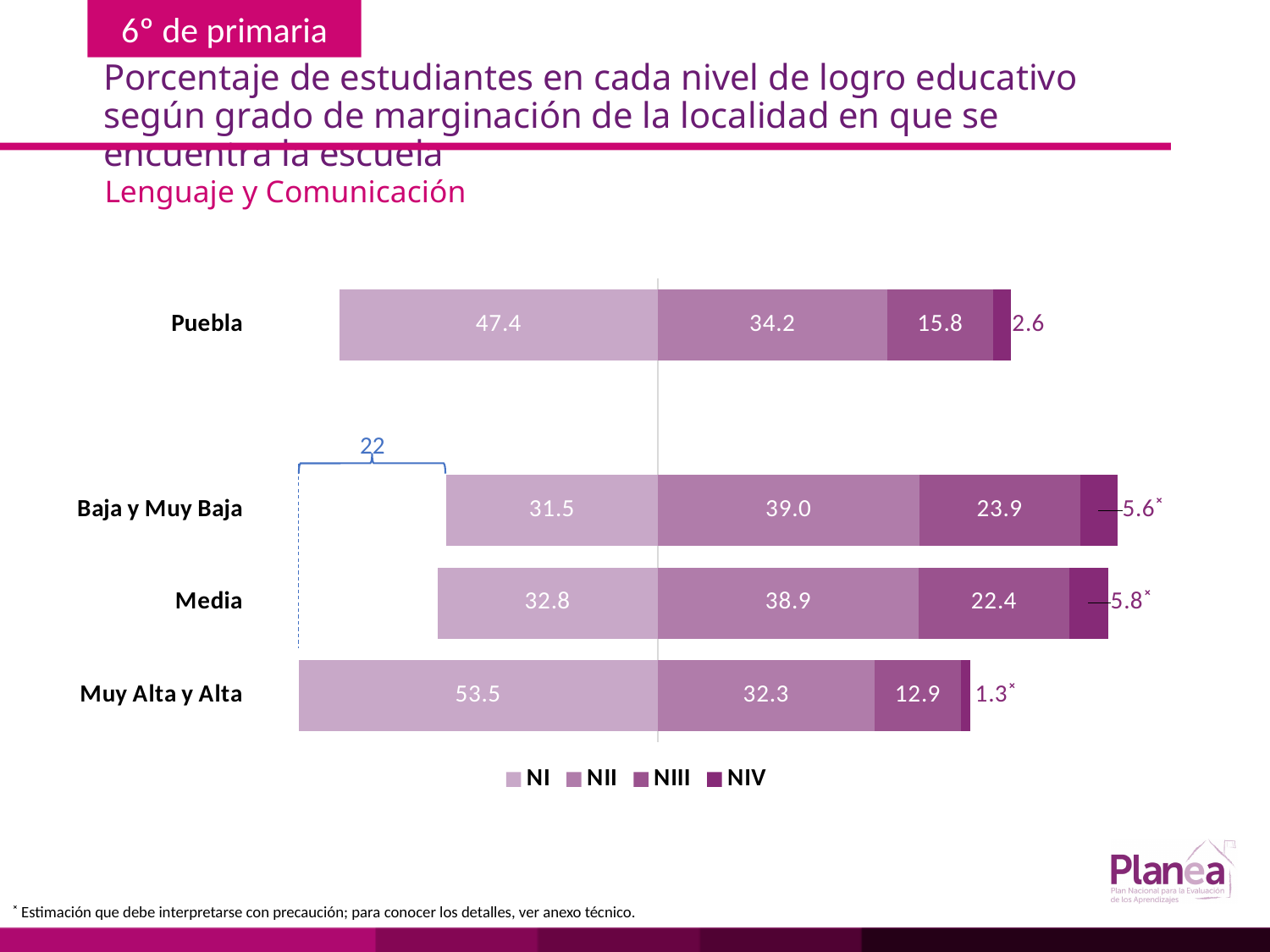
What is the NIV value for Baja y Muy Baja? 5.6 What is the difference between the NI values of Muy Alta y Alta and Baja y Muy Baja? 22 What percentage of students in Puebla are at level NI? 47.4 What is the NII value for Muy Alta y Alta? 32.3 Which category has the highest NI value? Muy Alta y Alta Which is larger, the NIII value for Baja y Muy Baja or for Media? Baja y Muy Baja What kind of chart is shown on the slide? Stacked bar chart What is the NIII value for the Media marginalization category? 22.4 What subject does the chart subtitle refer to? Lenguaje y Comunicación Which category has the lowest NIV value? Muy Alta y Alta How many series does the legend list? 4 How many categories are shown on the chart? 4